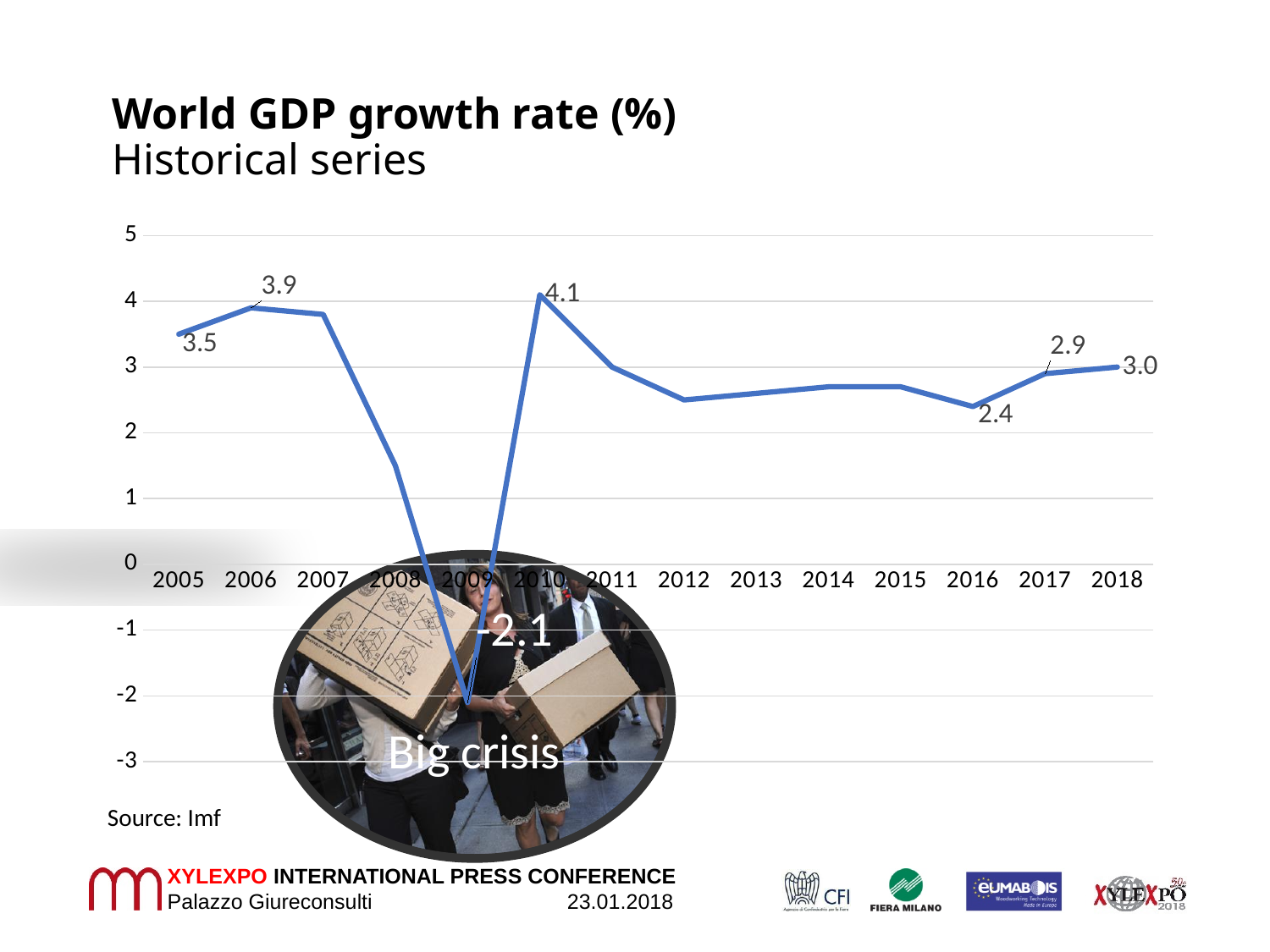
Which year has the lowest world GDP growth rate? 2009 What is the world GDP growth rate for 2005? 3.5 What is the source cited for the chart data? Imf What is the world GDP growth rate for 2016? 2.4 What is the difference between the growth rate in 2017 and the growth rate in 2016? 0.5 Which year has the highest world GDP growth rate? 2010 How many years are plotted on the x axis? 14 What is the difference between the growth rate in 2010 and the growth rate in 2009? 6.2 What type of chart is shown on the slide? line chart Which year has a higher growth rate, 2006 or 2018? 2006 What is the world GDP growth rate for 2010? 4.1 Is the growth rate for 2008 greater or less than 2? less